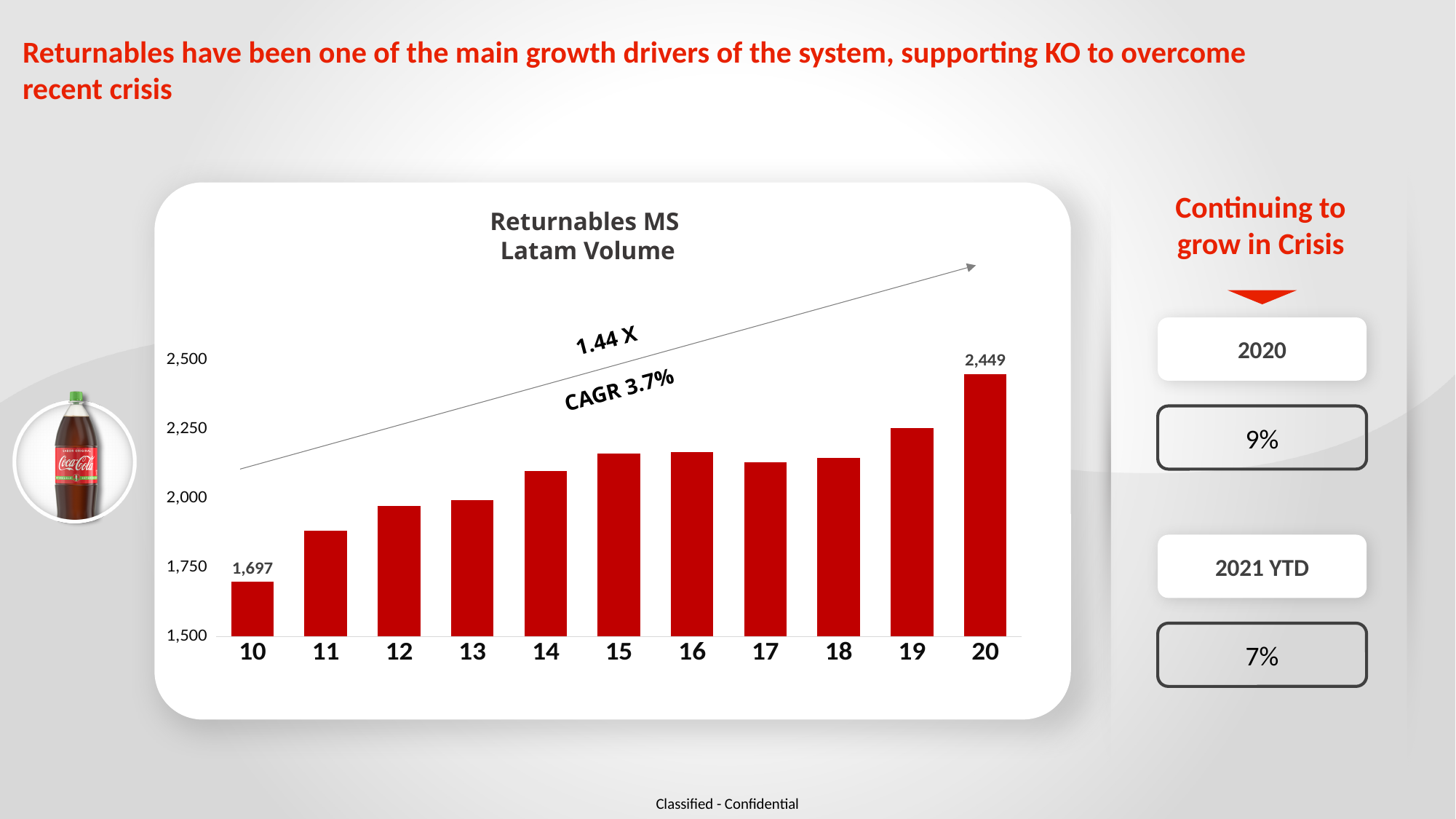
Which year has the lowest bar in the chart? 10 What is the difference between the values for year 20 and year 10? 752 What is the value for year 10 in the Returnables MS Latam Volume chart? 1,697 What CAGR is annotated on the chart? 3.7% Do the values generally rise or fall from year 10 to year 20? rise How many years are shown on the x axis of the chart? 11 Is the value for year 11 greater or less than 2,000? less What kind of chart is shown on the slide? bar chart Which year has the larger value, 18 or 19? 19 Which year has the highest bar in the chart? 20 What is the value for year 20 in the Returnables MS Latam Volume chart? 2,449 Is the value for year 14 greater or less than 2,000? greater